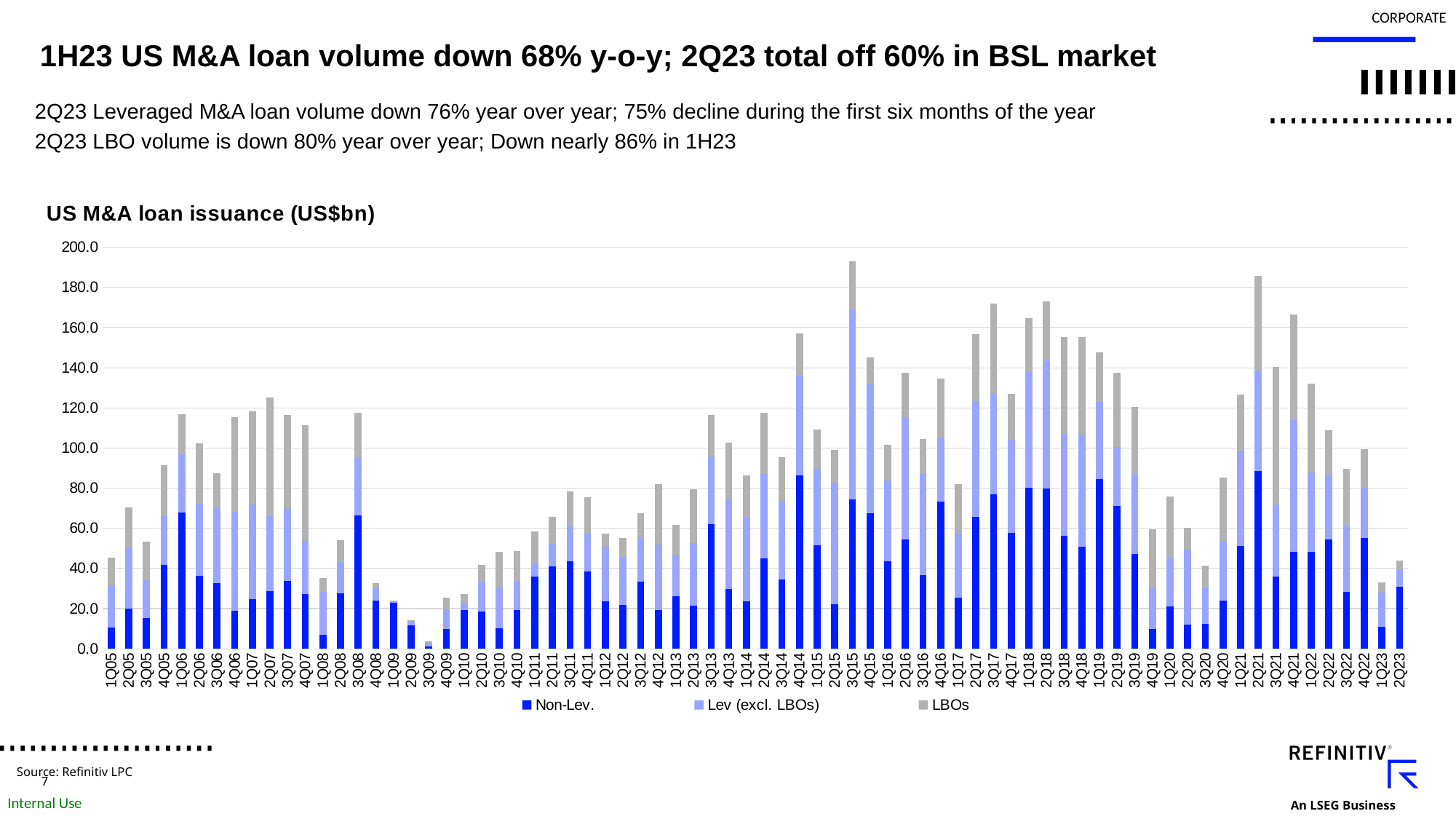
Which quarter has a larger total issuance, 1Q23 or 2Q23? 2Q23 What is the title of the chart? US M&A loan issuance (US$bn) Which quarter has a larger total issuance, 3Q15 or 4Q14? 3Q15 Is the total value for 2Q23 greater or less than 60.0? less How many series does the legend list? 3 What kind of chart is shown on the slide? Stacked bar chart What are the three series listed in the legend? Non-Lev., Lev (excl. LBOs), LBOs Which quarter has the lowest total US M&A loan issuance? 3Q09 Is the total value for 3Q09 greater or less than 20.0? less Is the total value for 3Q15 greater or less than 180.0? greater How many quarters are plotted on the x axis? 74 Which quarter has the highest total US M&A loan issuance? 3Q15